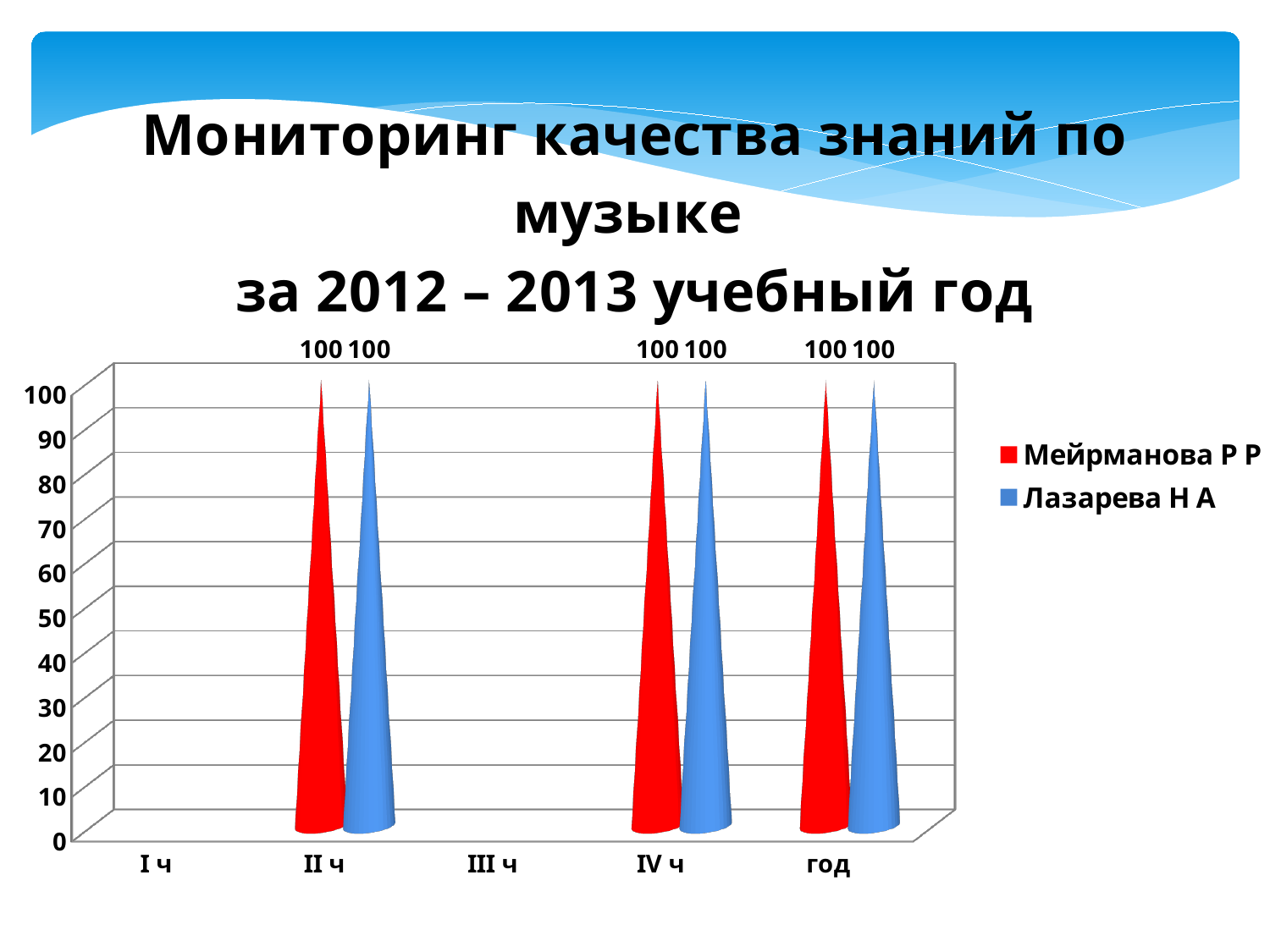
What kind of chart is shown on the slide? bar chart Which series is shown in blue in the legend? Лазарева Н А Which categories on the x axis have no bars plotted? I ч and III ч What is the value for Мейрманова Р Р in II ч? 100 How many series does the legend list? 2 Is the value for Лазарева Н А for год greater or less than 50? greater What is the value for Лазарева Н А in II ч? 100 What is the difference between the values for Мейрманова Р Р and Лазарева Н А in IV ч? 0 What is the value for Лазарева Н А in IV ч? 100 What is the value for Мейрманова Р Р for год? 100 How many categories are shown on the x axis? 5 Which series is shown in red in the legend? Мейрманова Р Р